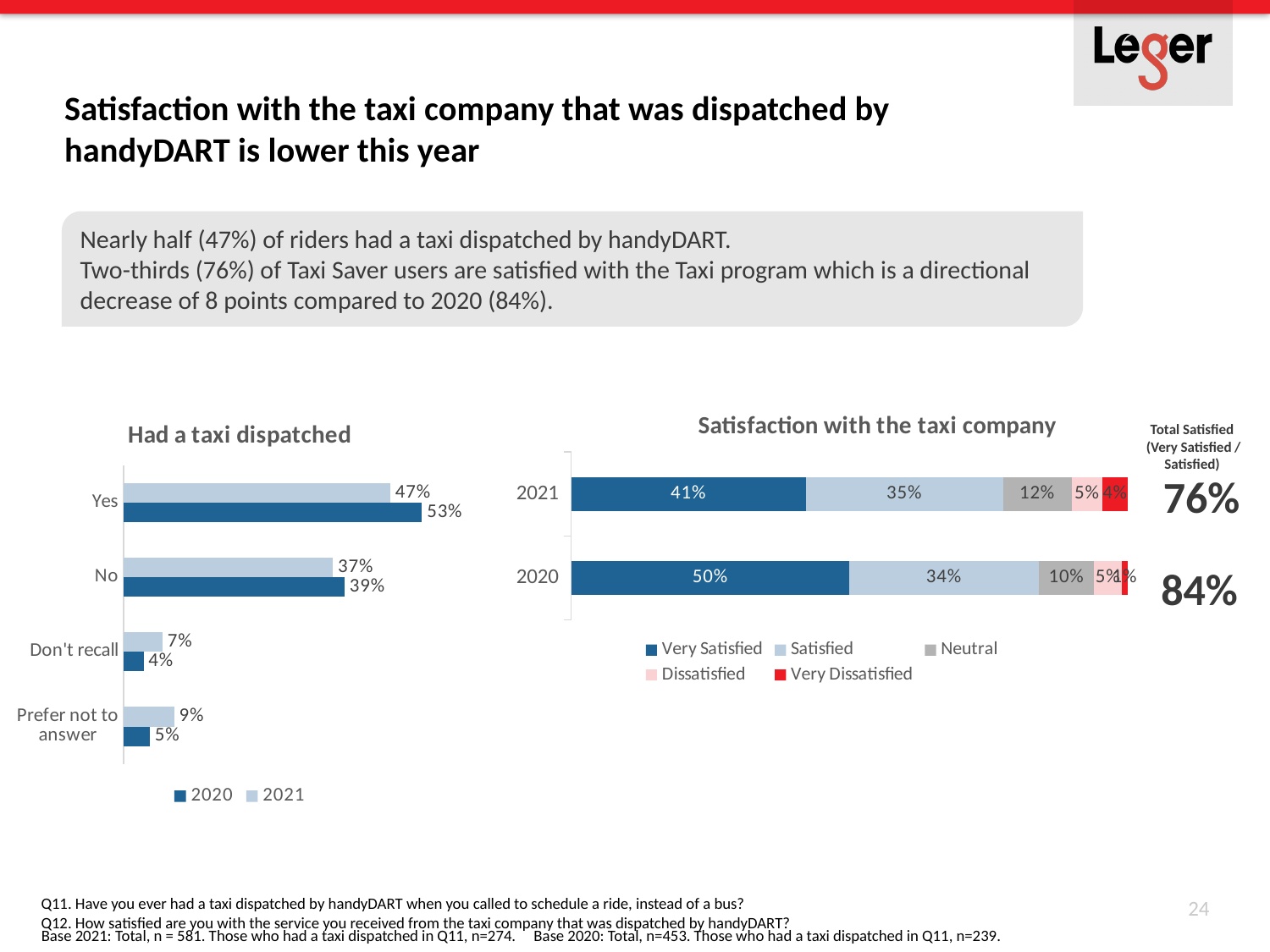
In the 'Satisfaction with the taxi company' chart, what percentage were Neutral in 2020? 10% In the 'Satisfaction with the taxi company' chart, what percentage were Very Satisfied in 2021? 41% What type of chart is 'Satisfaction with the taxi company'? Stacked bar chart In the 'Satisfaction with the taxi company' chart, how many series does the legend list? 5 In the 'Had a taxi dispatched' chart, what is the 2020 value for No? 39% In the 'Had a taxi dispatched' chart, which category has the lowest 2020 value? Don't recall In the 'Had a taxi dispatched' chart, which category has the highest 2020 value? Yes In the 'Had a taxi dispatched' chart, what is the 2021 value for Yes? 47% In the 'Had a taxi dispatched' chart, what is the difference between the 2020 and 2021 values for Yes? 6 percentage points In the 'Had a taxi dispatched' chart, what is the 2021 value for Prefer not to answer? 9% In the 'Satisfaction with the taxi company' chart, which year has the larger Very Satisfied share, 2020 or 2021? 2020 In the 'Had a taxi dispatched' chart, how many categories are shown? 4